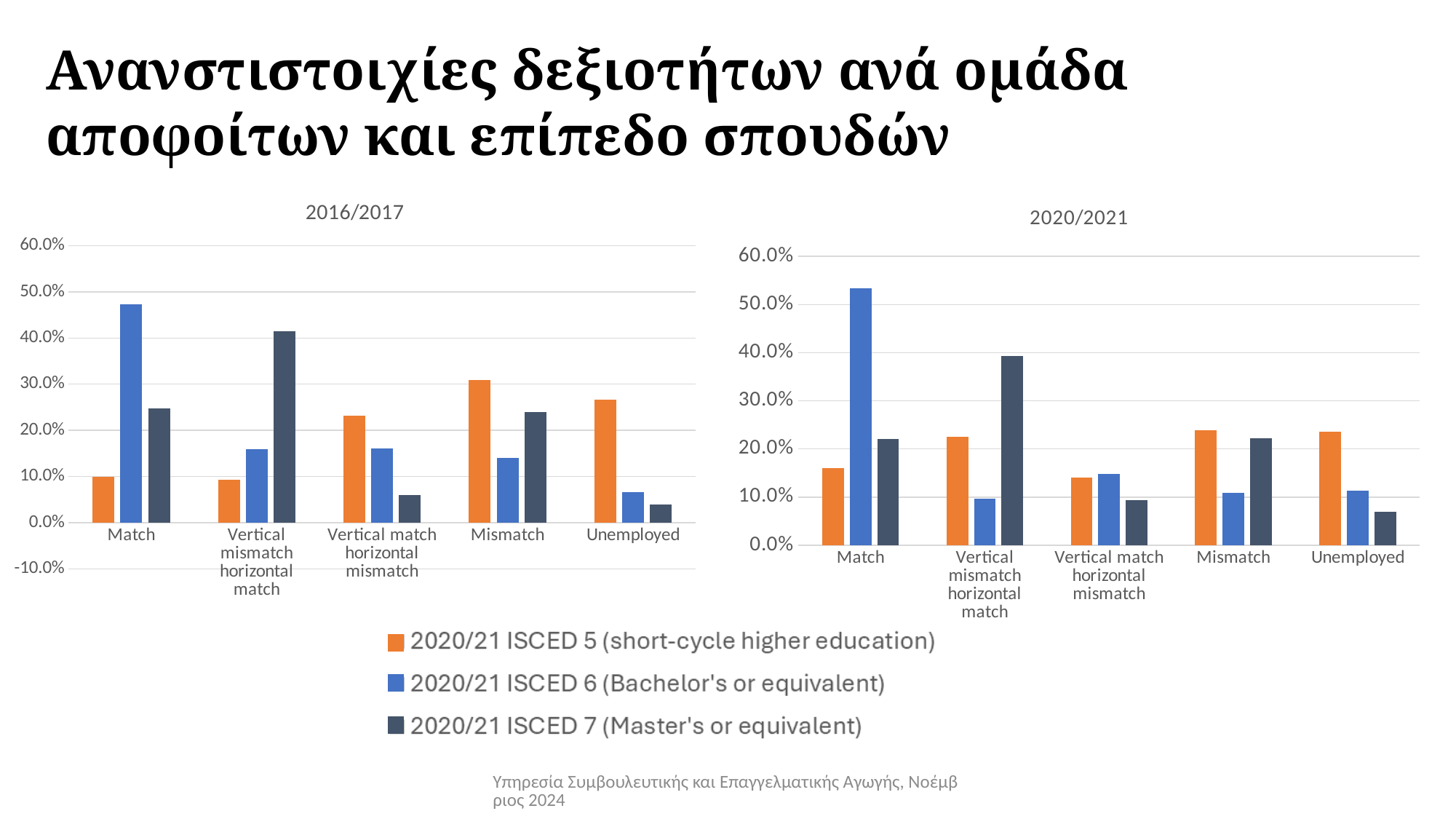
In the 2020/2021 chart, which category has the lowest value for ISCED 7 (Master's or equivalent)? Unemployed In the 2016/2017 chart, which category has the highest value for ISCED 6 (Bachelor's or equivalent)? Match In the 2020/2021 chart, which category has the highest value for ISCED 7 (Master's or equivalent)? Vertical mismatch horizontal match In the 2016/2017 chart, for the Mismatch category, which is larger: ISCED 5 or ISCED 7? ISCED 5 How many series does the legend list? 3 In the 2020/2021 chart, is the value for ISCED 6 (Bachelor's or equivalent) in the Match category greater or less than 50.0%? greater In the 2020/2021 chart, for the Match category, which is larger: ISCED 5 or ISCED 7? ISCED 7 In the 2016/2017 chart, is the value for ISCED 7 (Master's or equivalent) in the Vertical mismatch horizontal match category greater or less than 40.0%? greater What kind of chart is the 2016/2017 chart? bar chart In the 2016/2017 chart, is the value for ISCED 7 (Master's or equivalent) in the Unemployed category greater or less than 10.0%? less How many categories are shown on the x axis of the 2020/2021 chart? 5 What colour represents ISCED 5 (short-cycle higher education) in the legend? orange